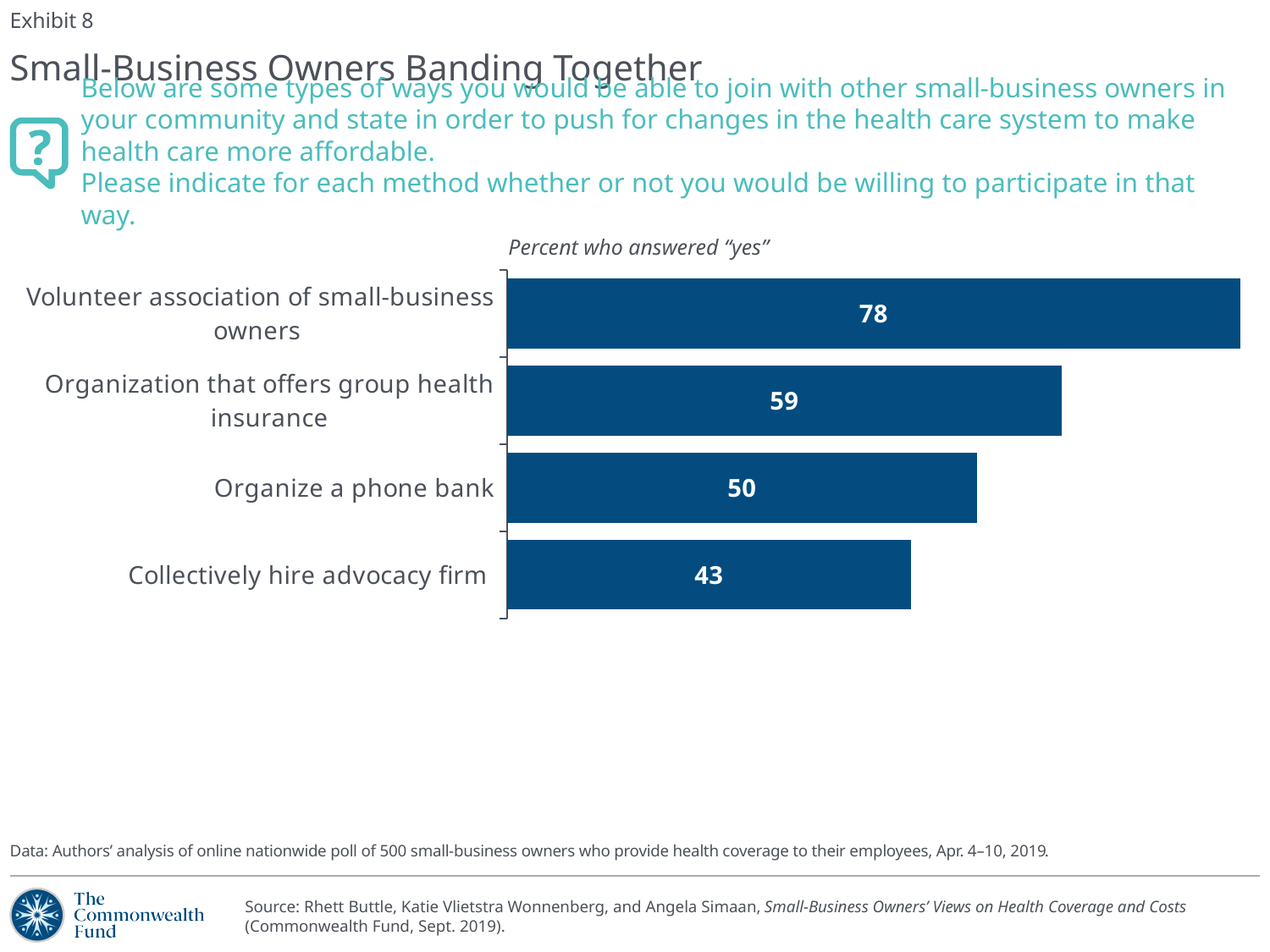
Which method has the lowest percent who answered "yes"? Collectively hire advocacy firm What percent answered "yes" to joining a volunteer association of small-business owners? 78 Which method has the highest percent who answered "yes"? Volunteer association of small-business owners What percent answered "yes" to an organization that offers group health insurance? 59 What kind of chart is shown on the slide? Bar chart What is the label shown above the bars describing what the values represent? Percent who answered "yes" What percent answered "yes" to organizing a phone bank? 50 Which has a higher percent answering "yes": organizing a phone bank or collectively hiring an advocacy firm? Organize a phone bank What percent answered "yes" to collectively hiring an advocacy firm? 43 What is the difference in percent answering "yes" between an organization that offers group health insurance and organizing a phone bank? 9 How many methods are shown in the chart? 4 What is the difference in percent answering "yes" between the volunteer association of small-business owners and collectively hiring an advocacy firm? 35